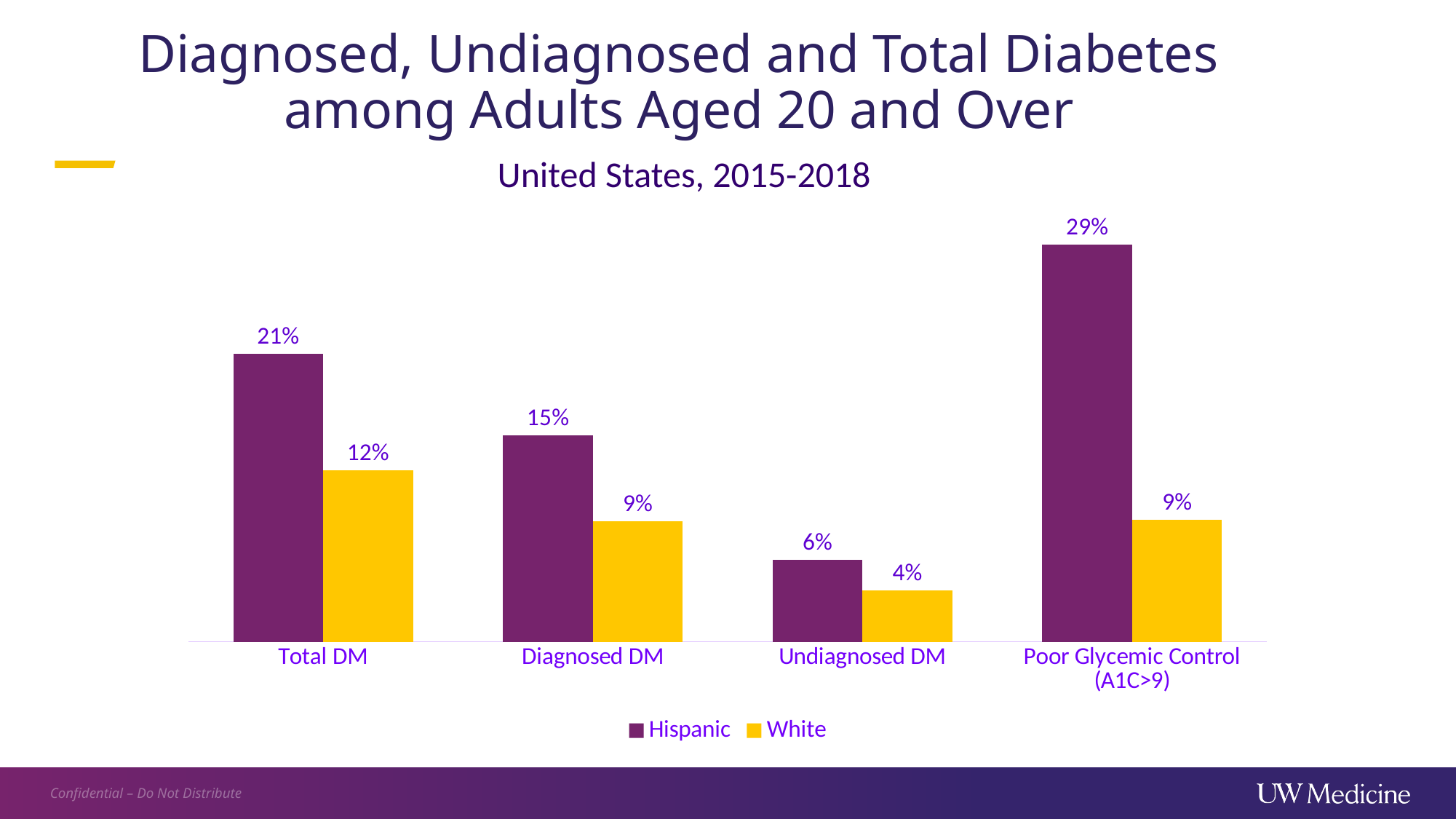
How many series does the legend list? 2 Which category has the highest Hispanic value? Poor Glycemic Control (A1C>9) How many categories are shown on the x axis? 4 What is the value for White in the Undiagnosed DM category? 4% What is the difference between the Hispanic and White values for Total DM? 9% What is the value for Hispanic in the Total DM category? 21% What kind of chart is shown on the slide? Bar chart What is the value for White in the Diagnosed DM category? 9% What is the value for Hispanic in the Poor Glycemic Control (A1C>9) category? 29% Which category has the lowest White value? Undiagnosed DM What is the difference between the Hispanic and White values for Poor Glycemic Control (A1C>9)? 20% Which is larger, the Hispanic value for Diagnosed DM or the White value for Total DM? Hispanic value for Diagnosed DM